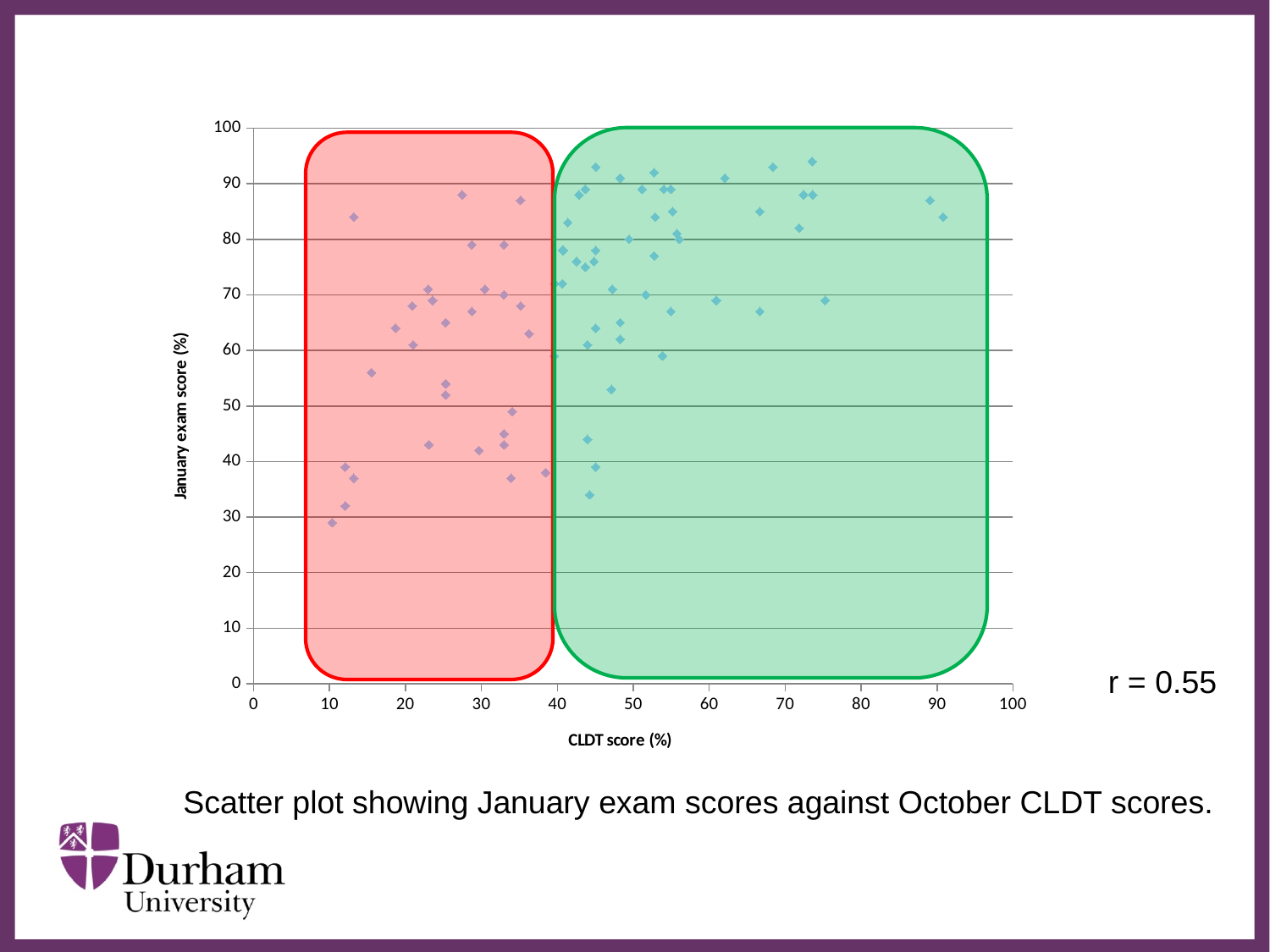
Is the lowest January exam score plotted greater or less than 40? less What is the label of the x axis? CLDT score (%) Is the highest January exam score plotted greater or less than 90? greater What is the maximum value shown on the y axis? 100 What kind of chart is shown on the slide? Scatter plot As CLDT score increases along the x axis, do January exam scores generally rise or fall? Rise What is the label of the y axis? January exam score (%)